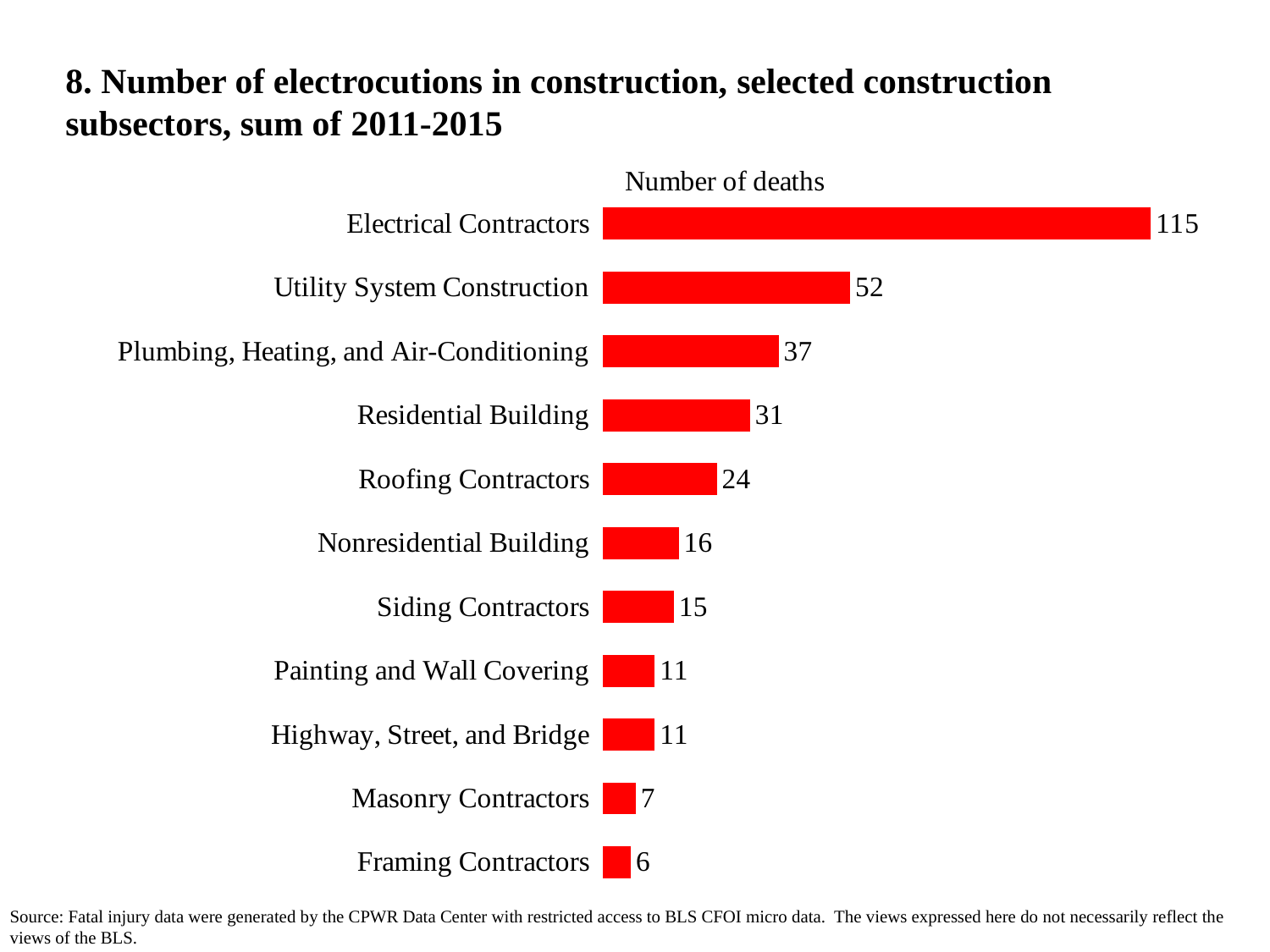
What is the label shown above the bars in the chart? Number of deaths What kind of chart is shown on the slide? Bar chart What is the number of deaths for Utility System Construction? 52 What is the difference in deaths between Electrical Contractors and Utility System Construction? 63 What is the number of deaths for Masonry Contractors? 7 How many electrocution deaths are shown for Electrical Contractors? 115 What is the number of deaths for Roofing Contractors? 24 Which subsector has the highest number of deaths? Electrical Contractors Which subsector has the lowest number of deaths? Framing Contractors Which has more deaths, Nonresidential Building or Siding Contractors? Nonresidential Building How many construction subsectors are shown in the chart? 11 What is the difference in deaths between Plumbing, Heating, and Air-Conditioning and Residential Building? 6